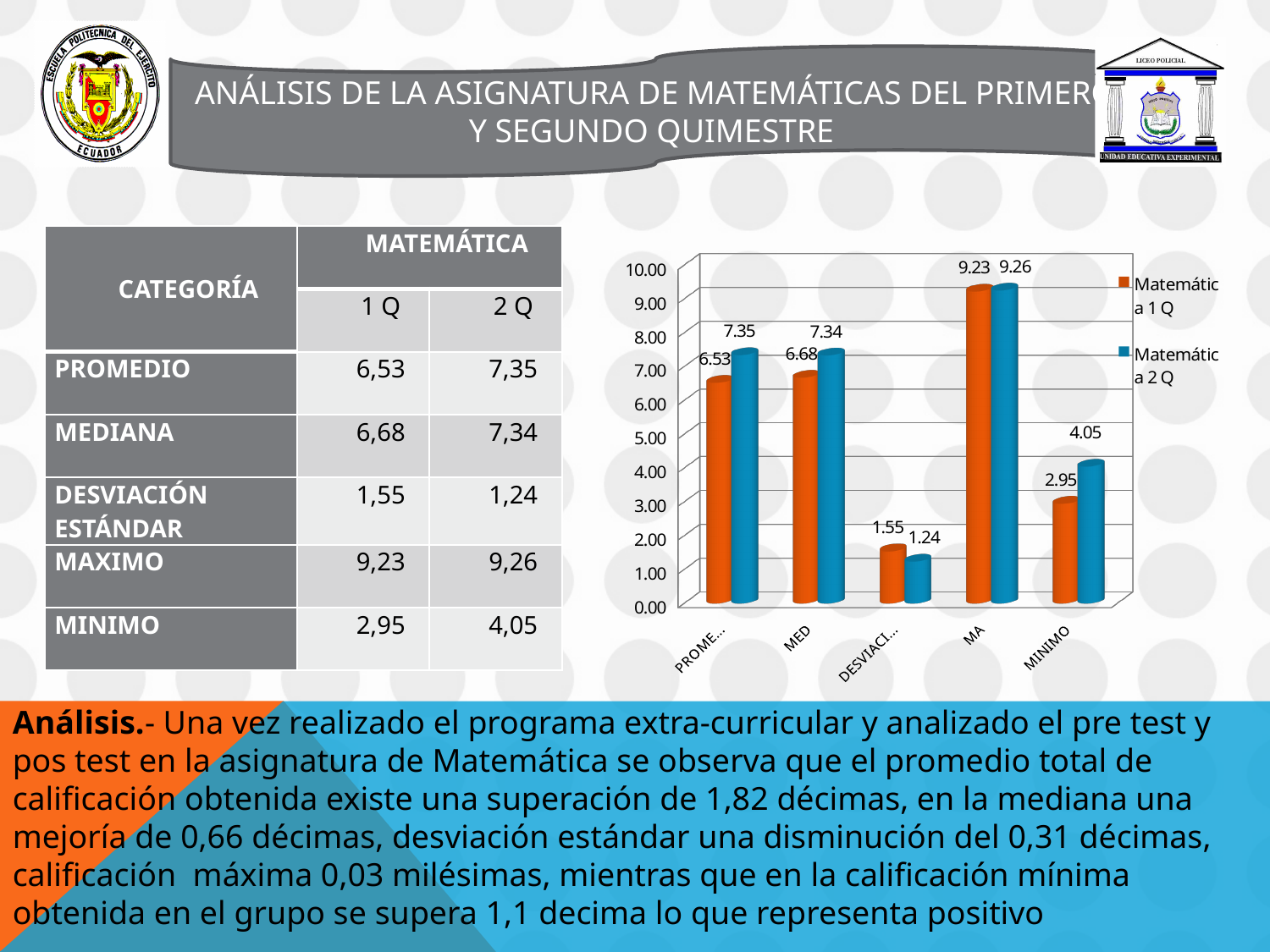
Which category has the highest value for Matemática 2 Q in the chart? MA What colour are the bars for the Matemática 1 Q series? orange What is the difference between the Matemática 2 Q and Matemática 1 Q values for the MINIMO category? 1.10 What is the value of Matemática 1 Q for the MINIMO category in the chart? 2.95 What is the value of Matemática 1 Q for the MED category in the chart? 6.68 Which category has the lowest value for Matemática 1 Q in the chart? DESVIACI... How many series does the chart legend list? 2 How many categories are plotted along the x axis of the chart? 5 Is the Matemática 1 Q value for the MA category greater or less than 9.00? greater What is the value of Matemática 2 Q for the MINIMO category in the chart? 4.05 What type of chart is shown on the slide? bar chart For the MINIMO category, which series has the larger value, Matemática 1 Q or Matemática 2 Q? Matemática 2 Q